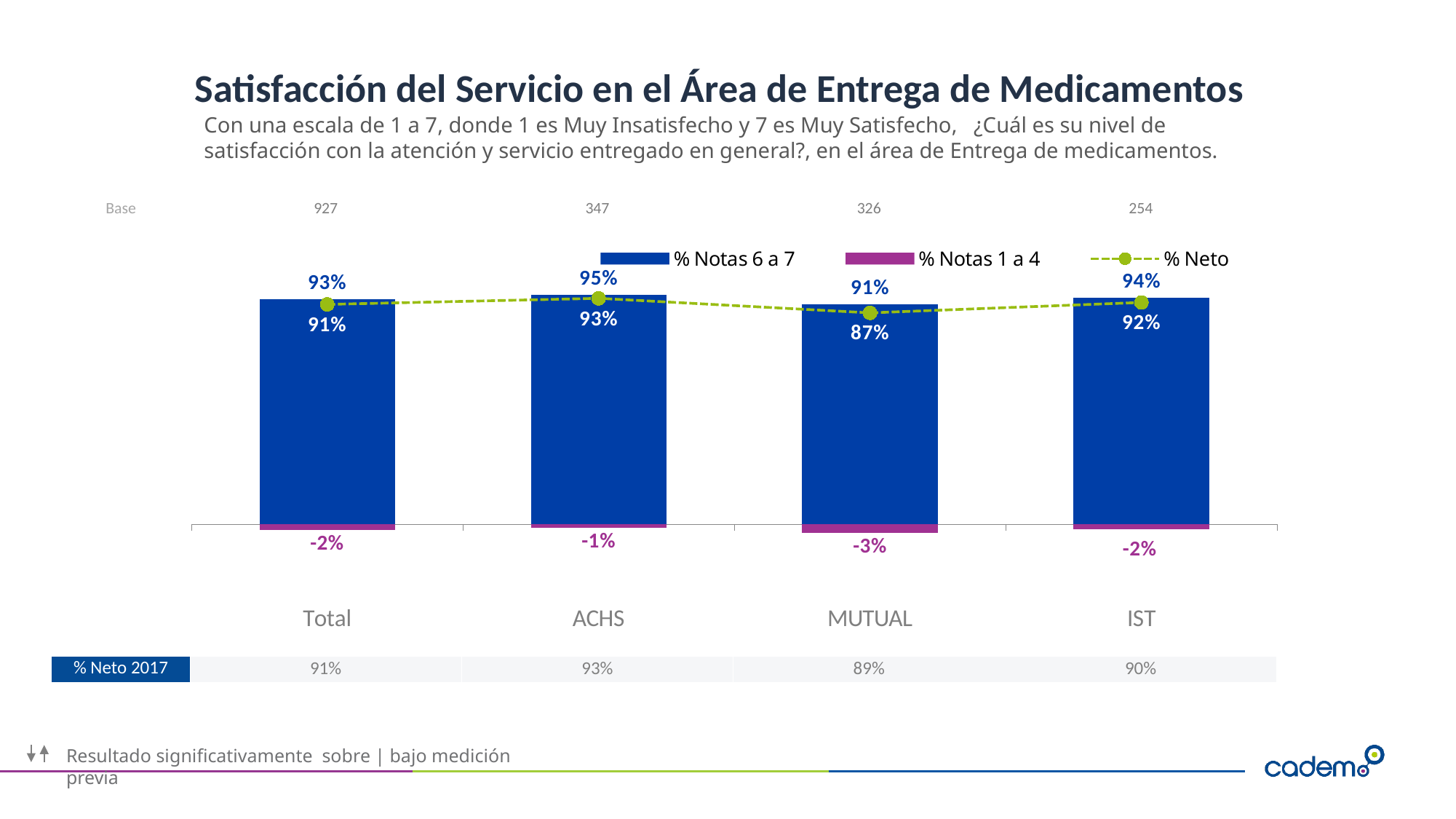
What is the Base value shown for Total? 927 What is the % Notas 6 a 7 value for ACHS? 95% What is the % Neto 2017 value shown for MUTUAL in the row below the chart? 89% Which is larger, the % Neto value for Total or for IST? IST Which category has the lowest % Neto value? MUTUAL What is the difference between the % Notas 6 a 7 values for ACHS and MUTUAL? 4% How many categories are shown on the x axis? 4 How many series does the legend list? 3 What is the % Neto value for MUTUAL? 87% What kind of chart is shown on the slide? Bar chart with a line What is the % Notas 1 a 4 value for IST? -2% Which category has the highest % Notas 6 a 7 value? ACHS